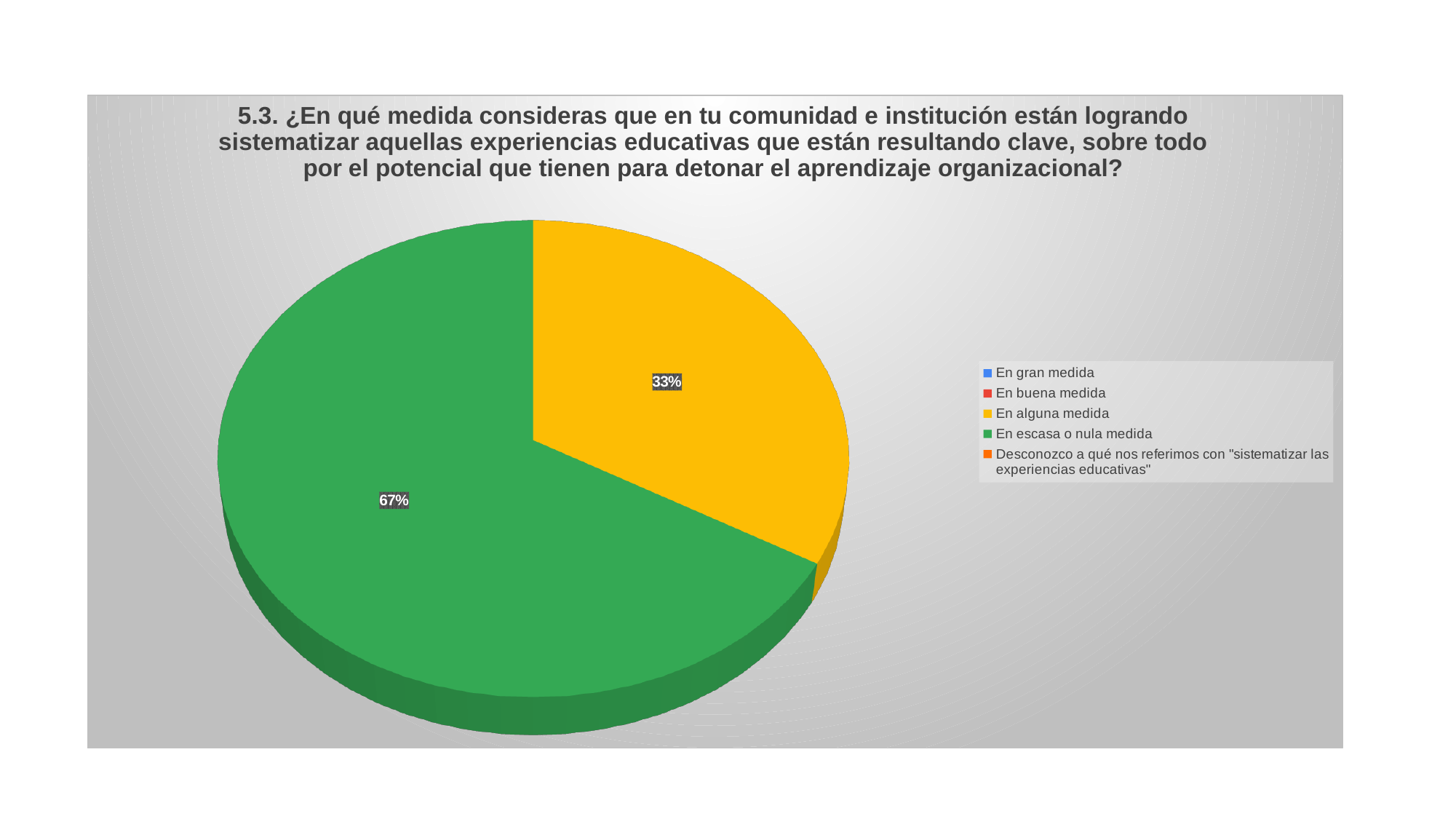
What kind of chart is shown on the slide? Pie chart What is the difference in percentage points between "En escasa o nula medida" and "En alguna medida"? 34 How many slices with a visible data label does the pie have? 2 What percentage is shown for "En escasa o nula medida"? 67% What colour is the slice for "En escasa o nula medida"? Green Which category has the largest slice of the pie? En escasa o nula medida What colour is the slice for "En alguna medida"? Yellow What percentage is shown for "En alguna medida"? 33% Which is larger, the slice for "En alguna medida" or the slice for "En escasa o nula medida"? En escasa o nula medida How many entries does the legend list? 5